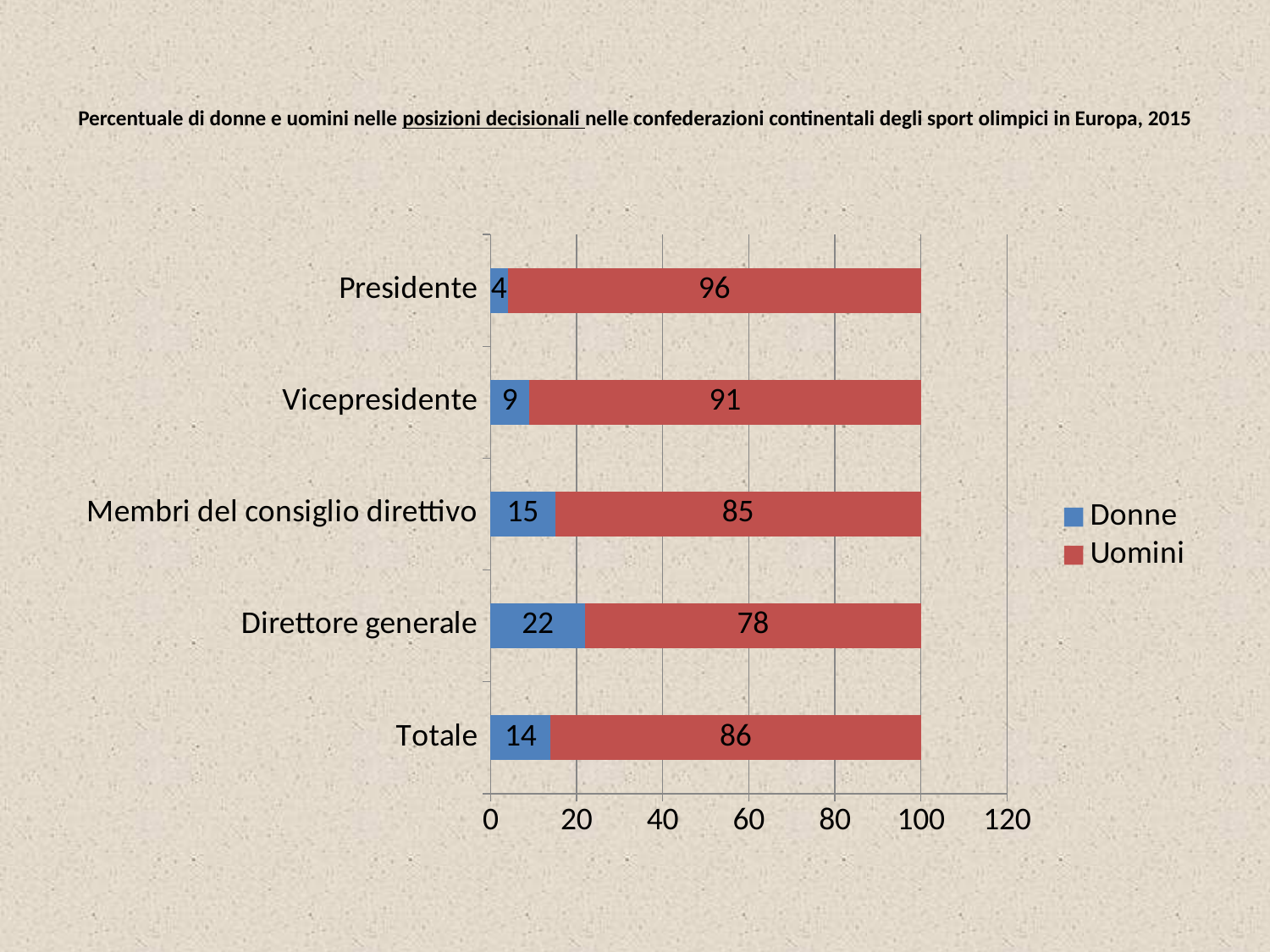
Which is larger: the Donne value for Vicepresidente or the Donne value for Totale? Totale What is the Uomini value for Direttore generale? 78 What is the Donne value for Presidente? 4 How many categories are shown on the chart? 5 What kind of chart is shown on the slide? Stacked bar chart What is the Donne value for Membri del consiglio direttivo? 15 What is the total of the stacked bar for Vicepresidente? 100 How many series does the legend list? 2 Which category has the lowest Donne value? Presidente Which category has the highest Donne value? Direttore generale What is the Uomini value for Totale? 86 What is the difference between the Uomini value for Presidente and the Uomini value for Direttore generale? 18